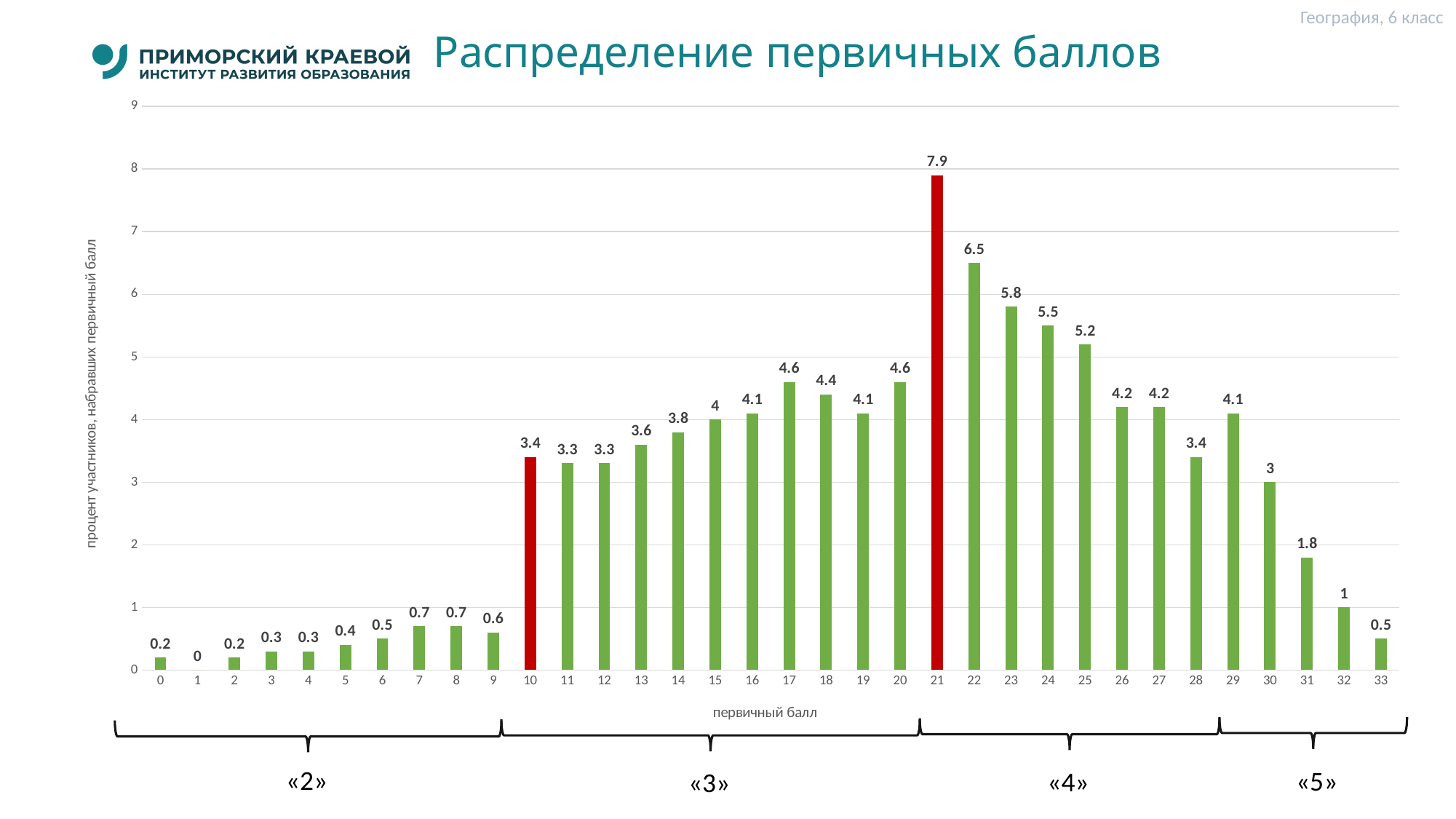
What is the value for primary score 21? 7.9 Do the values rise or fall from primary score 21 to primary score 25? fall What is the difference between the values for primary scores 21 and 22? 1.4 Is the value for primary score 22 greater or less than 6? greater Which primary score has the highest percentage of participants? 21 What is the value for primary score 10? 3.4 Which is larger, the value for primary score 23 or for primary score 25? 23 What is the value for primary score 33? 0.5 Which primary score has the lowest percentage of participants? 1 What kind of chart is shown on the slide? bar chart Which two primary scores are highlighted with red bars? 10 and 21 How many primary score categories are shown on the x axis? 34